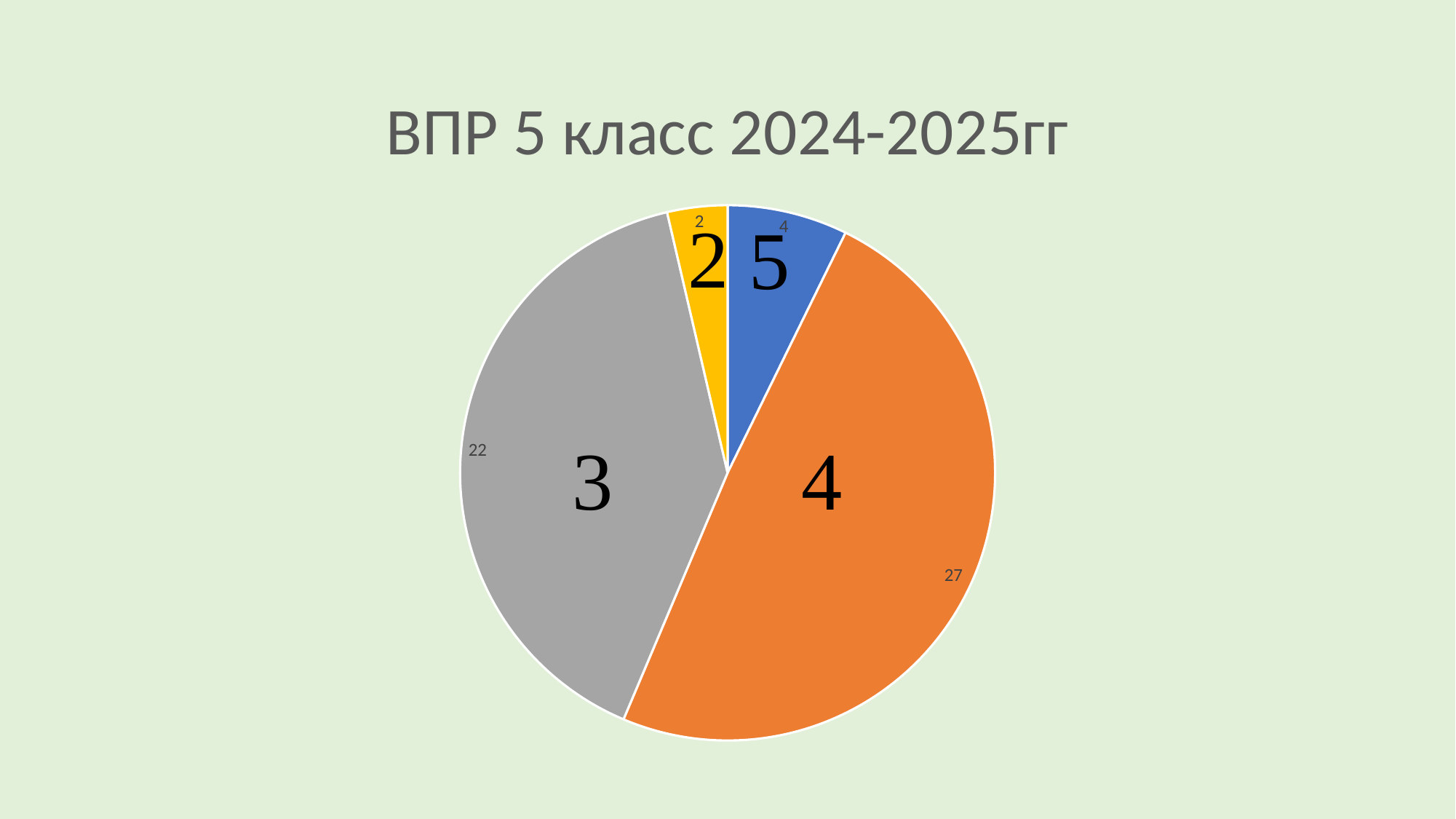
What is the value of the slice for grade 2? 2 Which grade has the smallest slice in the pie chart? 2 Which is larger, the value for grade 5 or the value for grade 2? grade 5 What is the value of the slice for grade 5? 4 What is the title of the pie chart? ВПР 5 класс 2024-2025гг What type of chart is shown on the slide? pie chart What is the value of the slice for grade 3? 22 Which grade has the largest slice in the pie chart? 4 How many slices does the pie chart have? 4 What is the difference between the values for grade 4 and grade 3? 5 What share of the pie does the grade 3 slice represent? 40% What is the value of the slice for grade 4? 27